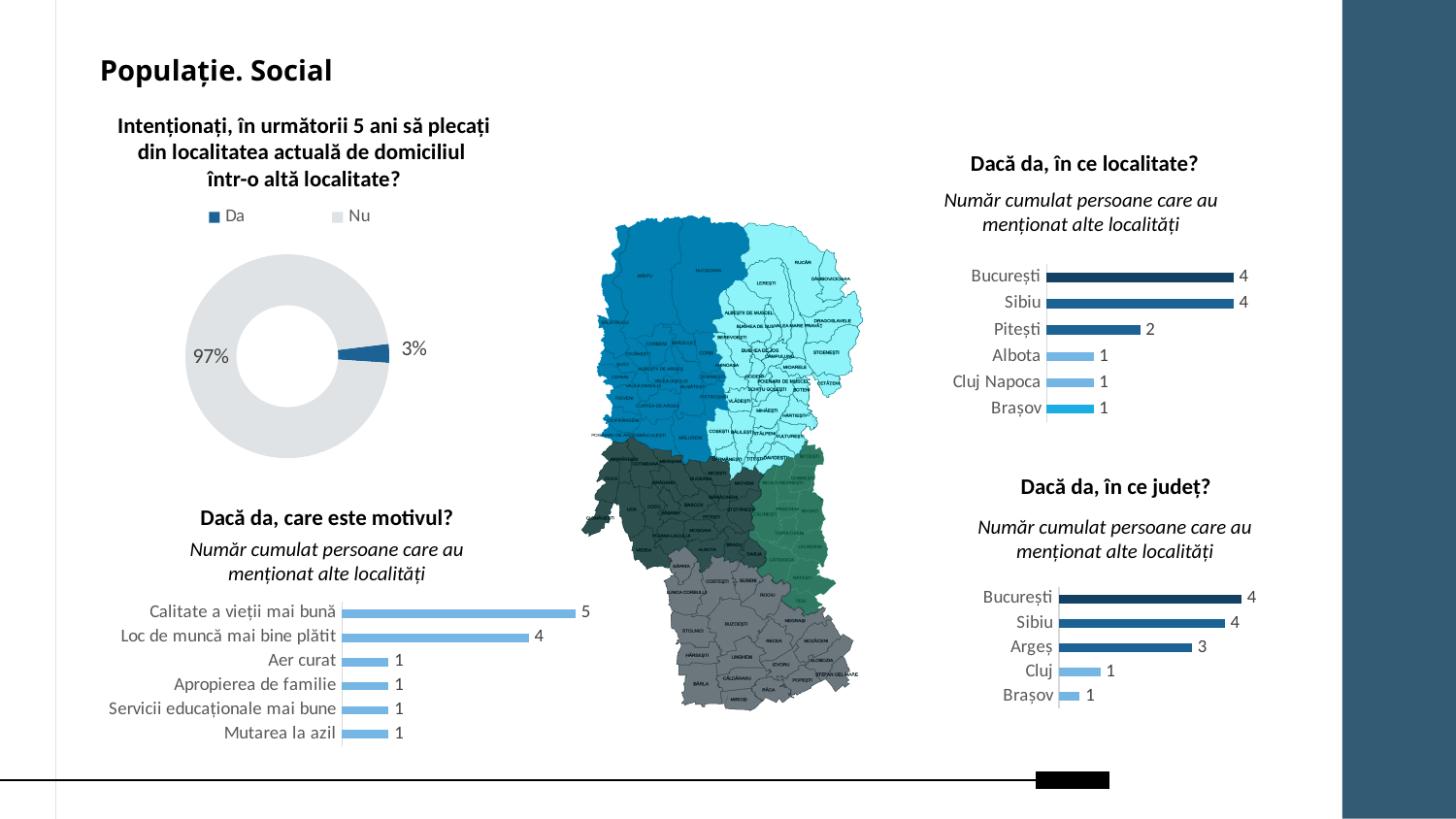
In the "Dacă da, în ce localitate?" chart, what is the value for Pitești? 2 In the donut chart about intending to leave the current locality in the next 5 years, what share answered "Nu"? 97% In the "Dacă da, în ce localitate?" chart, how many localities are listed? 6 In the "Dacă da, în ce județ?" chart, what is the value for Argeș? 3 In the "Dacă da, care este motivul?" chart, what is the difference between "Calitate a vieții mai bună" and "Loc de muncă mai bine plătit"? 1 In the "Dacă da, care este motivul?" chart, what is the value for "Calitate a vieții mai bună"? 5 In the "Dacă da, care este motivul?" chart, which reason has the highest value? Calitate a vieții mai bună What kind of chart is "Dacă da, în ce județ?"? Bar chart What kind of chart is used for the "Intenționați, în următorii 5 ani să plecați..." question? Donut (pie) chart In the "Dacă da, care este motivul?" chart, how many reasons are listed? 6 In the donut chart about intending to leave the current locality in the next 5 years, what share answered "Da"? 3% In the "Dacă da, în ce județ?" chart, which is larger, the value for Argeș or the value for Cluj? Argeș